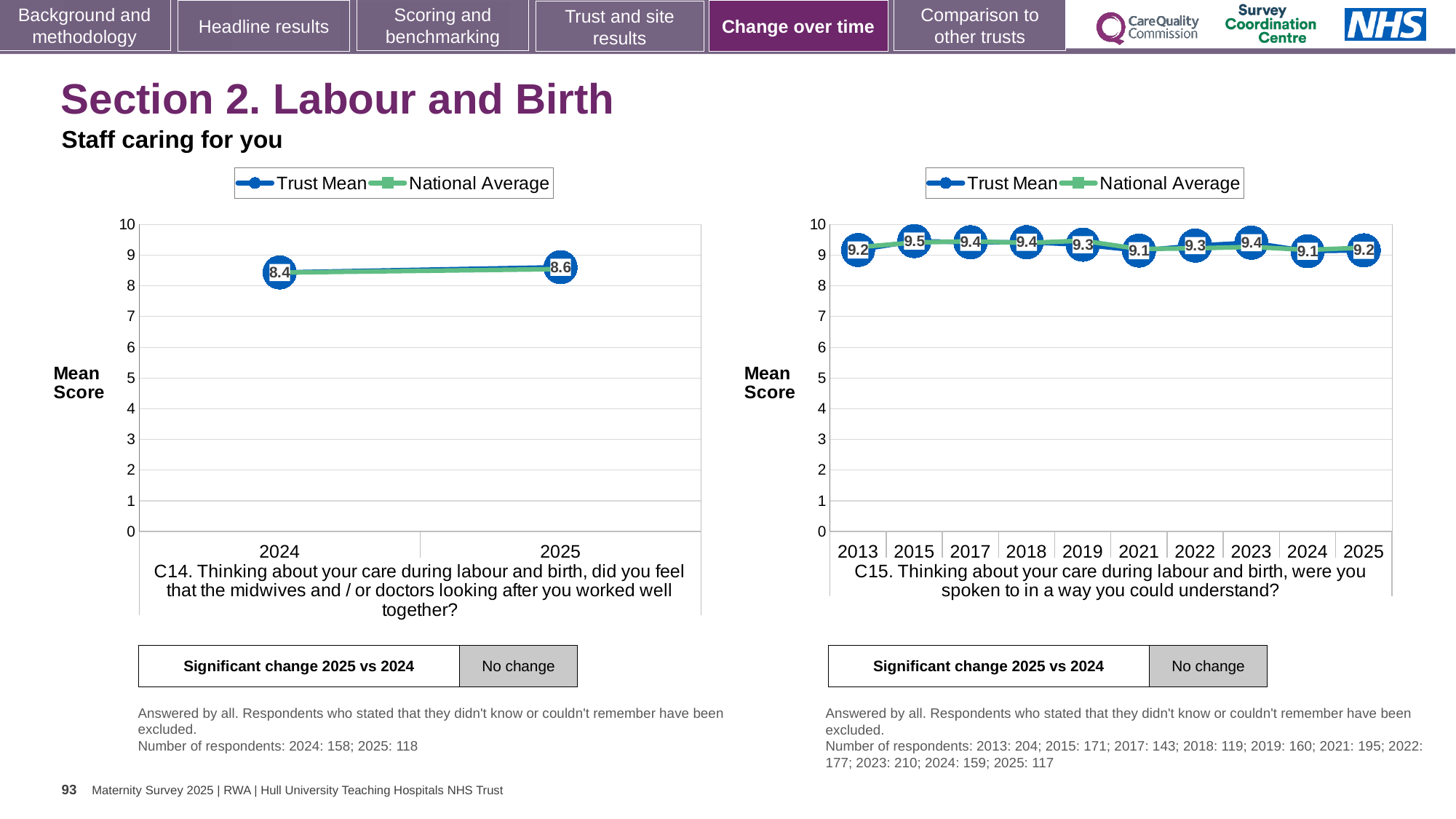
In the C14 chart on the left, what is the Trust Mean for 2024? 8.4 In the C14 chart on the left, by how much did the Trust Mean change from 2024 to 2025? 0.2 In the C15 chart on the right, is the Trust Mean higher in 2023 or in 2024? 2023 In the C15 chart on the right, what is the difference between the Trust Mean in 2015 and in 2021? 0.4 In the C14 chart on the left, what is the Trust Mean for 2025? 8.6 In the C15 chart on the right, how many years are plotted on the x axis? 10 In the C15 chart on the right, which year has the highest Trust Mean? 2015 What type of chart is the C14 chart on the left? Line chart In the C14 chart on the left, how many years are shown on the x axis? 2 In the C15 chart on the right, what is the Trust Mean for 2015? 9.5 How many series does the legend of the C15 chart on the right list? 2 In the C15 chart on the right, what is the Trust Mean for 2025? 9.2